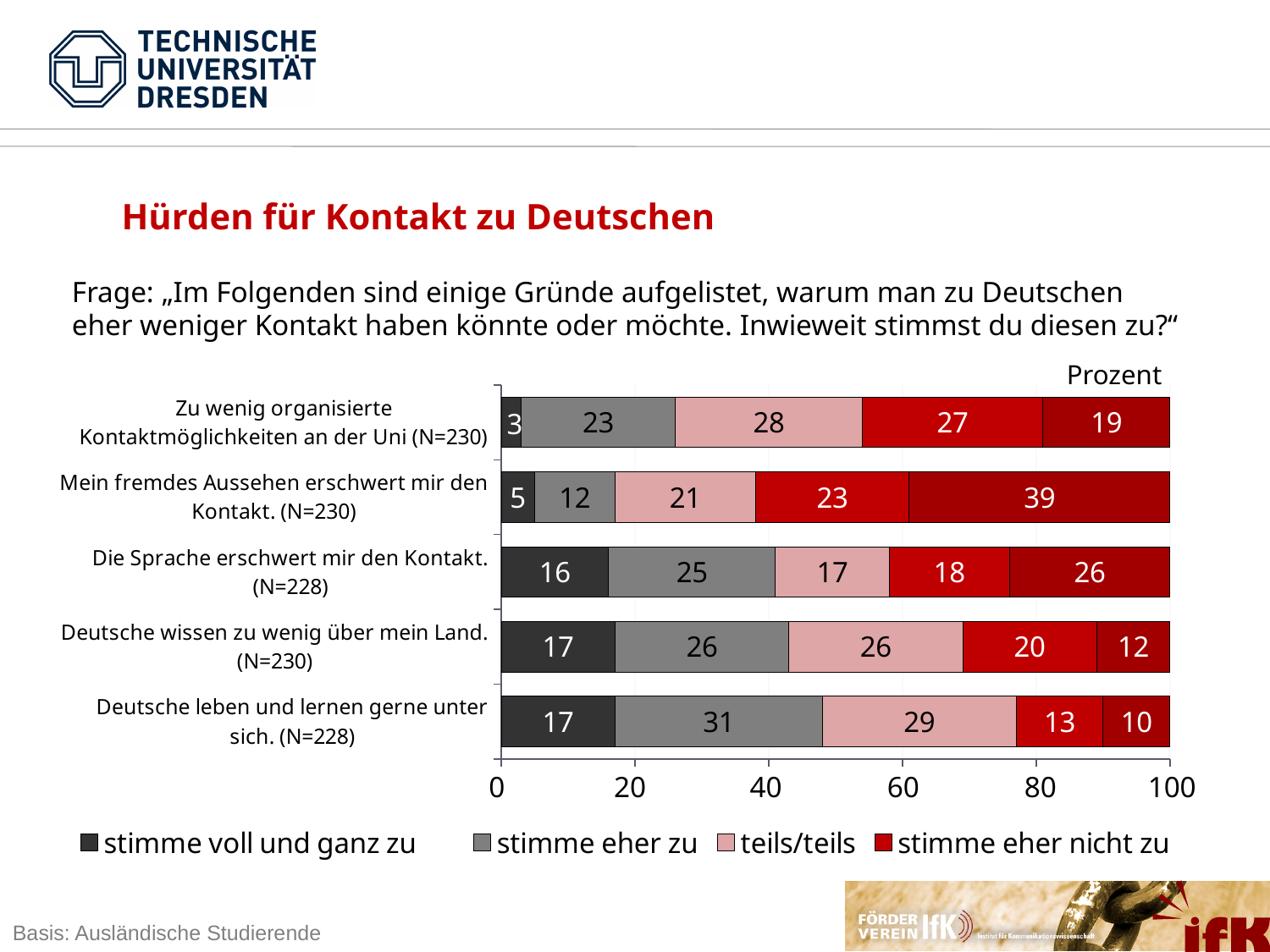
What kind of chart is shown on the slide? stacked bar chart What is the total of all segments in the bar for "Deutsche wissen zu wenig über mein Land. (N=230)"? 101 What is the difference between the "teils/teils" values for "Deutsche leben und lernen gerne unter sich. (N=228)" and "Die Sprache erschwert mir den Kontakt. (N=228)"? 12 How many statements (categories) are shown in the chart? 5 Which statement has the lowest value for "stimme voll und ganz zu"? Zu wenig organisierte Kontaktmöglichkeiten an der Uni (N=230) What is the value for "stimme eher zu" for "Deutsche leben und lernen gerne unter sich. (N=228)"? 31 What unit label is shown above the chart's x axis? Prozent What is the value for "teils/teils" for "Zu wenig organisierte Kontaktmöglichkeiten an der Uni (N=230)"? 28 What is the value for "stimme voll und ganz zu" for "Die Sprache erschwert mir den Kontakt. (N=228)"? 16 What is the value for "stimme eher nicht zu" for "Mein fremdes Aussehen erschwert mir den Kontakt. (N=230)"? 23 Which is larger: the "stimme eher nicht zu" value for "Zu wenig organisierte Kontaktmöglichkeiten an der Uni (N=230)" or for "Deutsche wissen zu wenig über mein Land. (N=230)"? Zu wenig organisierte Kontaktmöglichkeiten an der Uni (N=230) Which statement has the highest value for "stimme eher zu"? Deutsche leben und lernen gerne unter sich. (N=228)